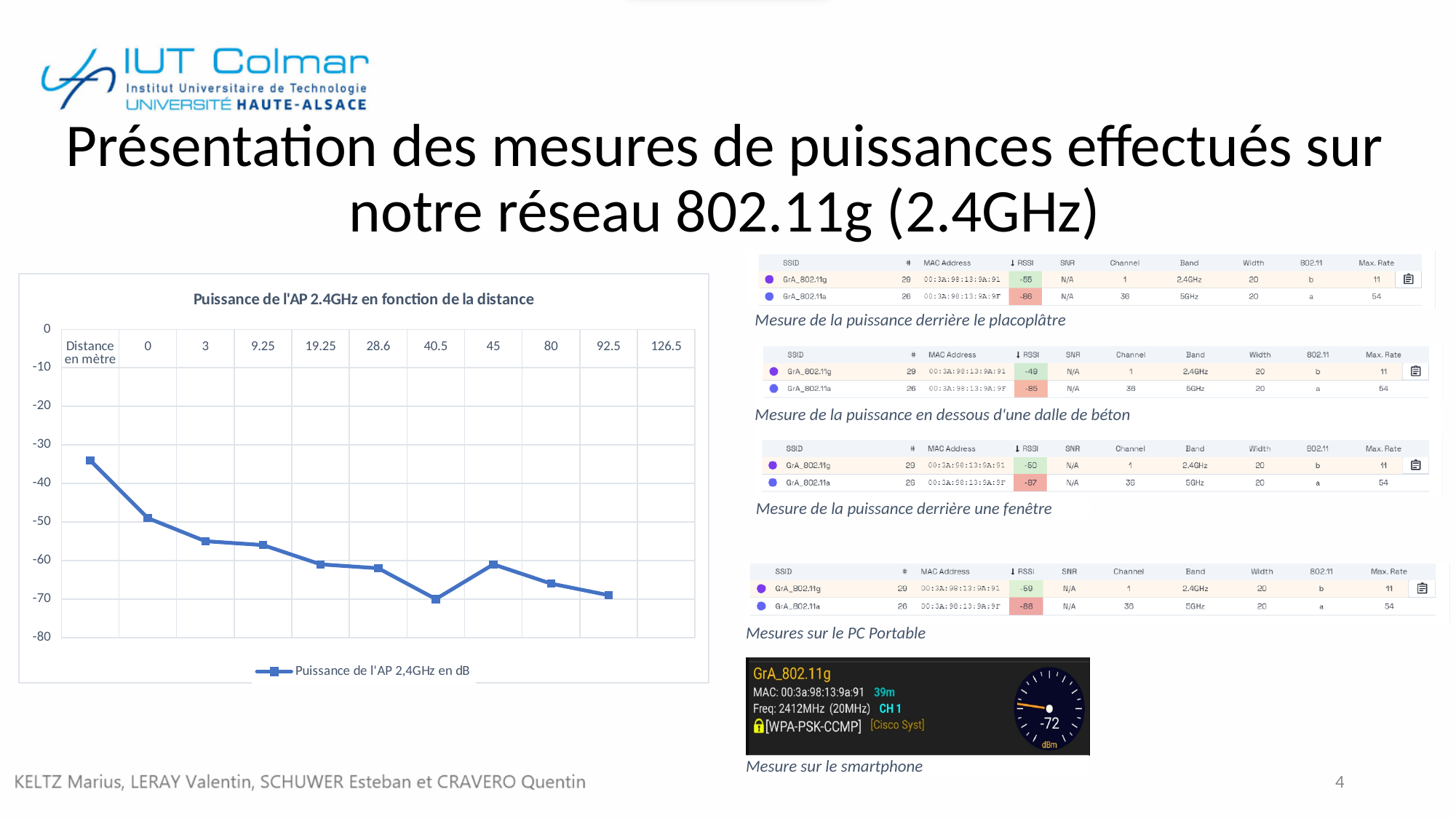
Is the value at distance 0 greater or less than -40? less What is the legend entry of the plotted series? Puissance de l'AP 2,4GHz en dB Overall, do the values rise or fall as the distance increases along the x axis? fall What is the title of the chart? Puissance de l'AP 2.4GHz en fonction de la distance How many distance points are plotted on the chart? 10 At which distance in metres is the plotted power highest? 0 At which distance in metres is the plotted power lowest? 40.5 Which has the larger value, distance 3 or distance 80? 3 How many series does the chart legend list? 1 What kind of chart is shown on the slide? line chart